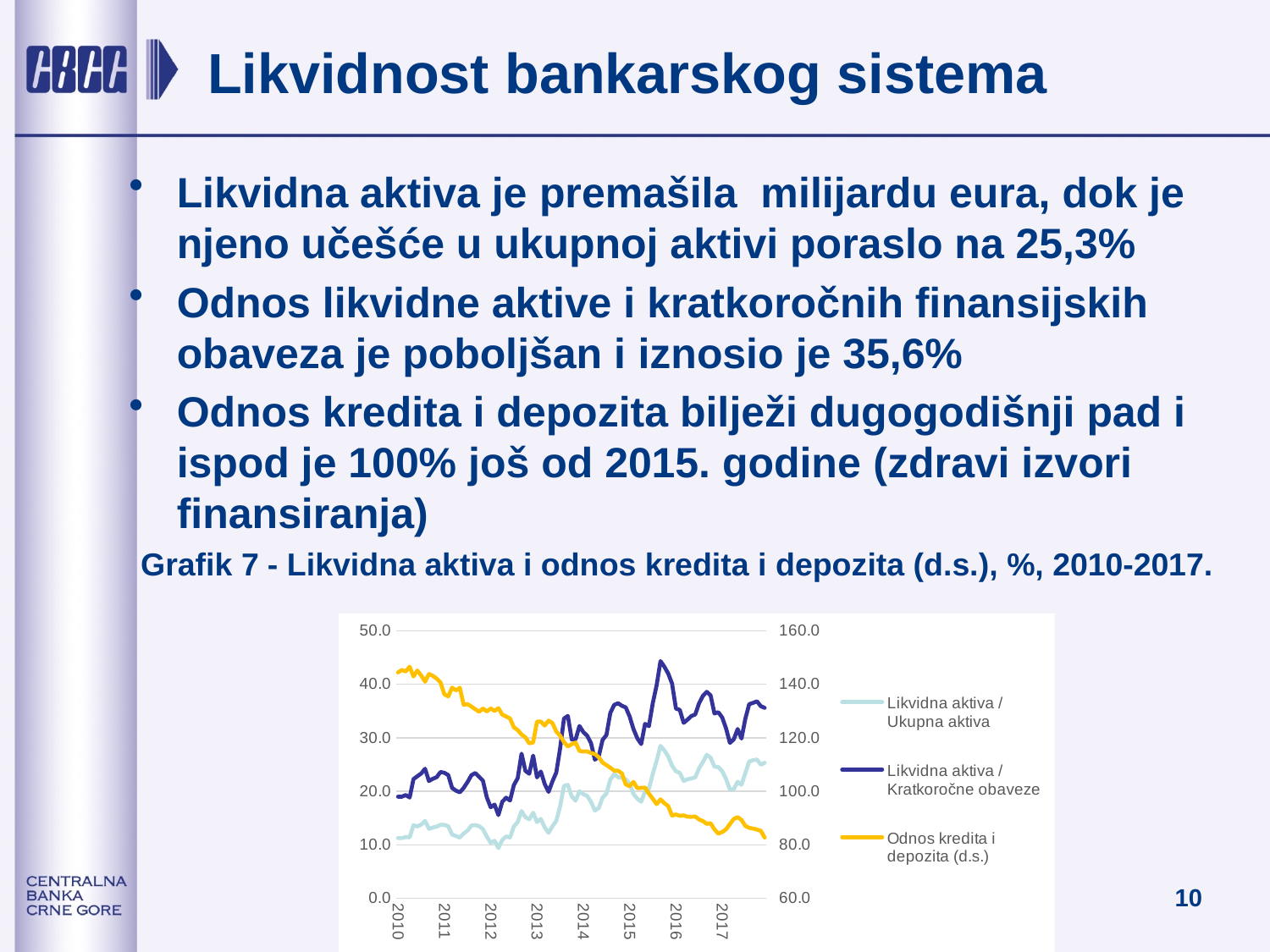
Does the Likvidna aktiva / Ukupna aktiva series rise or fall overall from 2010 to 2017? rise Is the value of Odnos kredita i depozita (d.s.) at the start of 2010 greater or less than 120? greater What kind of chart is shown on the slide? line chart Which series is plotted in yellow? Odnos kredita i depozita (d.s.) Is the value of Likvidna aktiva / Ukupna aktiva at the start of 2010 greater or less than 20? less How many series does the chart legend list? 3 Is the peak value of Likvidna aktiva / Kratkoročne obaveze around 2016 greater or less than 40? greater Does the Odnos kredita i depozita (d.s.) series rise or fall from 2010 to 2017? fall At the end of 2017, which is higher on the left axis: Likvidna aktiva / Kratkoročne obaveze or Likvidna aktiva / Ukupna aktiva? Likvidna aktiva / Kratkoročne obaveze How many years are labelled on the x axis? 8 What is the title of the chart on the slide? Grafik 7 - Likvidna aktiva i odnos kredita i depozita (d.s.), %, 2010-2017.